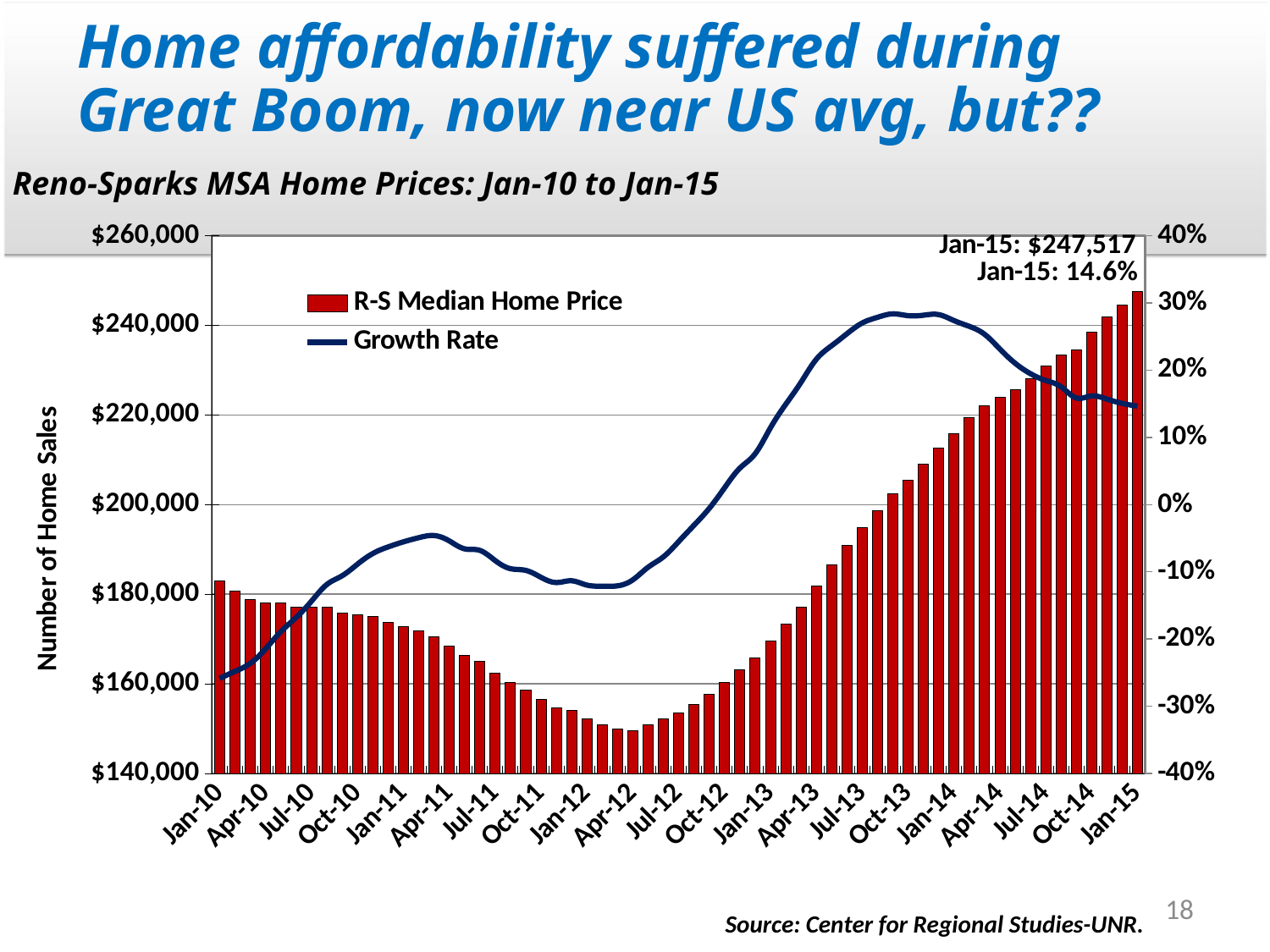
How many series does the legend list? 2 What is the Growth Rate for Jan-15? 14.6% What is the R-S Median Home Price for Jan-15? $247,517 Do the R-S Median Home Price bars rise or fall from Jan-10 to Apr-12? fall Is the R-S Median Home Price for Jan-10 greater or less than $180,000? greater What kind of chart is shown on the slide? Bar chart combined with a line chart Is the Growth Rate for Jan-10 greater or less than -20%? less What is the title of the chart? Reno-Sparks MSA Home Prices: Jan-10 to Jan-15 Which month has the highest R-S Median Home Price? Jan-15 Is the Growth Rate for Oct-13 greater or less than 20%? greater Which is larger, the R-S Median Home Price for Jan-15 or for Jan-10? Jan-15